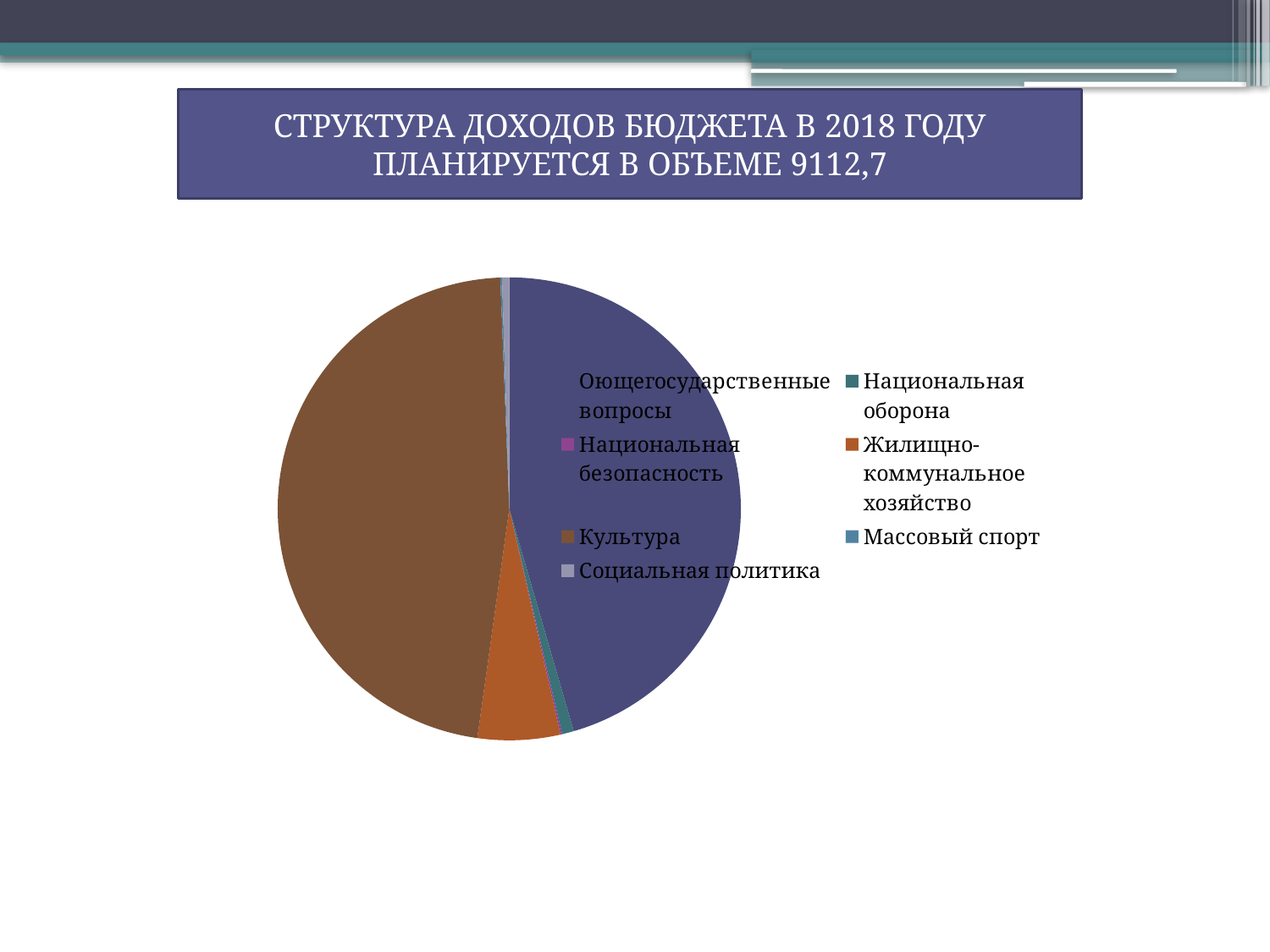
What total amount is stated in the slide title for the 2018 budget revenue structure? 9112,7 How many categories does the legend of the pie chart list? 7 What colour is the slice for Жилищно-коммунальное хозяйство in the pie chart? orange Which slice is larger: Оющегосударственные вопросы or Жилищно-коммунальное хозяйство? Оющегосударственные вопросы Which slice is larger: Жилищно-коммунальное хозяйство or Национальная оборона? Жилищно-коммунальное хозяйство Which slice is larger: Культура or Оющегосударственные вопросы? Культура What kind of chart is shown on the slide? pie chart Which category has the largest slice of the pie chart? Культура